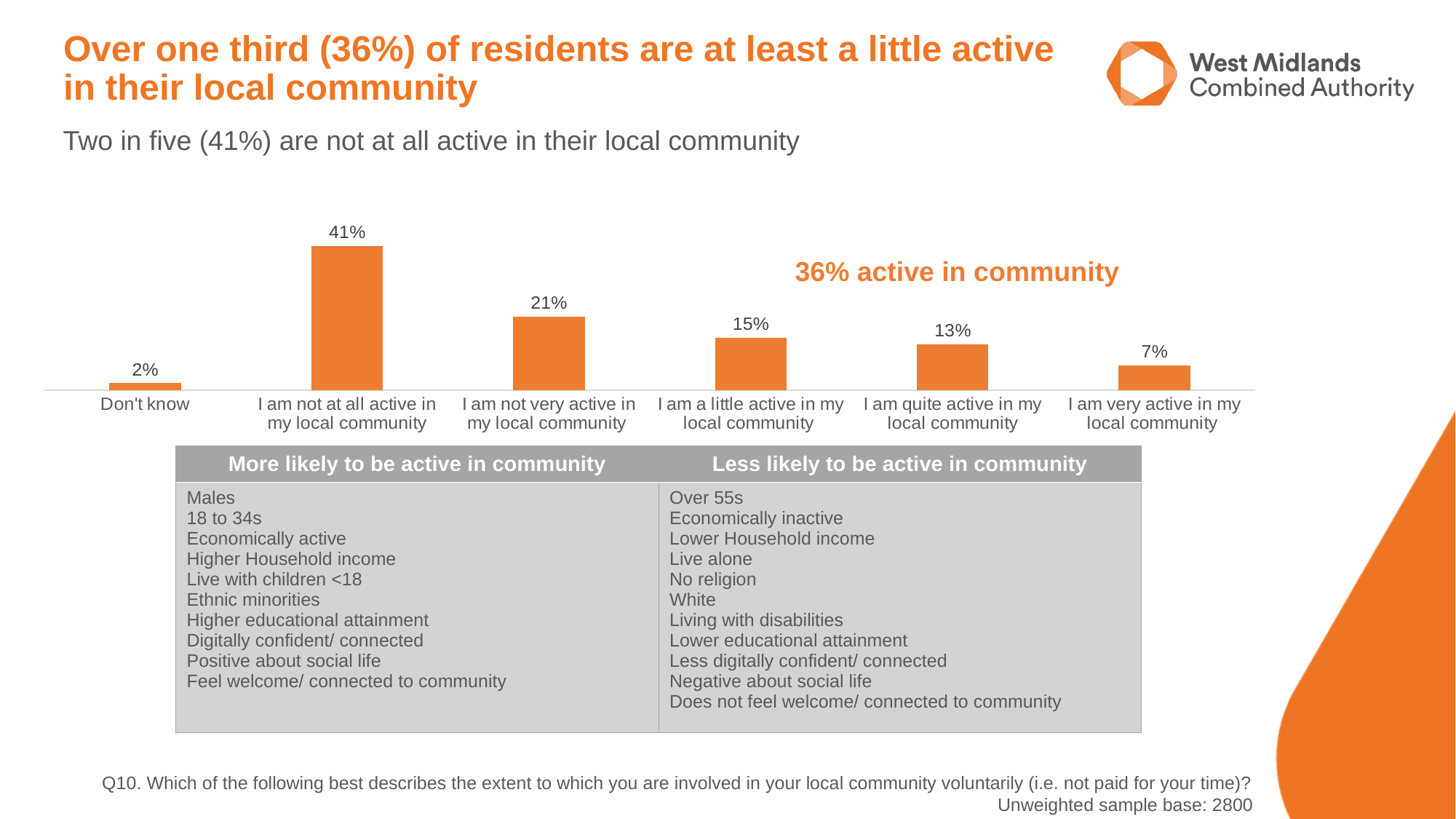
What is the value for 'I am quite active in my local community'? 13% Which category has the highest value in the chart? I am not at all active in my local community Which category has the lowest value in the chart? Don't know What percentage of residents answered 'Don't know'? 2% What is the difference between 'I am not at all active in my local community' and 'I am not very active in my local community'? 20% What percentage of residents say they are not at all active in their local community? 41% What is the combined total of the three 'active' categories (a little, quite, and very active)? 35% What is the unweighted sample base stated on the slide? 2800 How many categories are shown in the chart? 6 What kind of chart is shown on the slide? Bar chart Which is larger: 'I am a little active in my local community' or 'I am quite active in my local community'? I am a little active in my local community What is the value for 'I am very active in my local community'? 7%